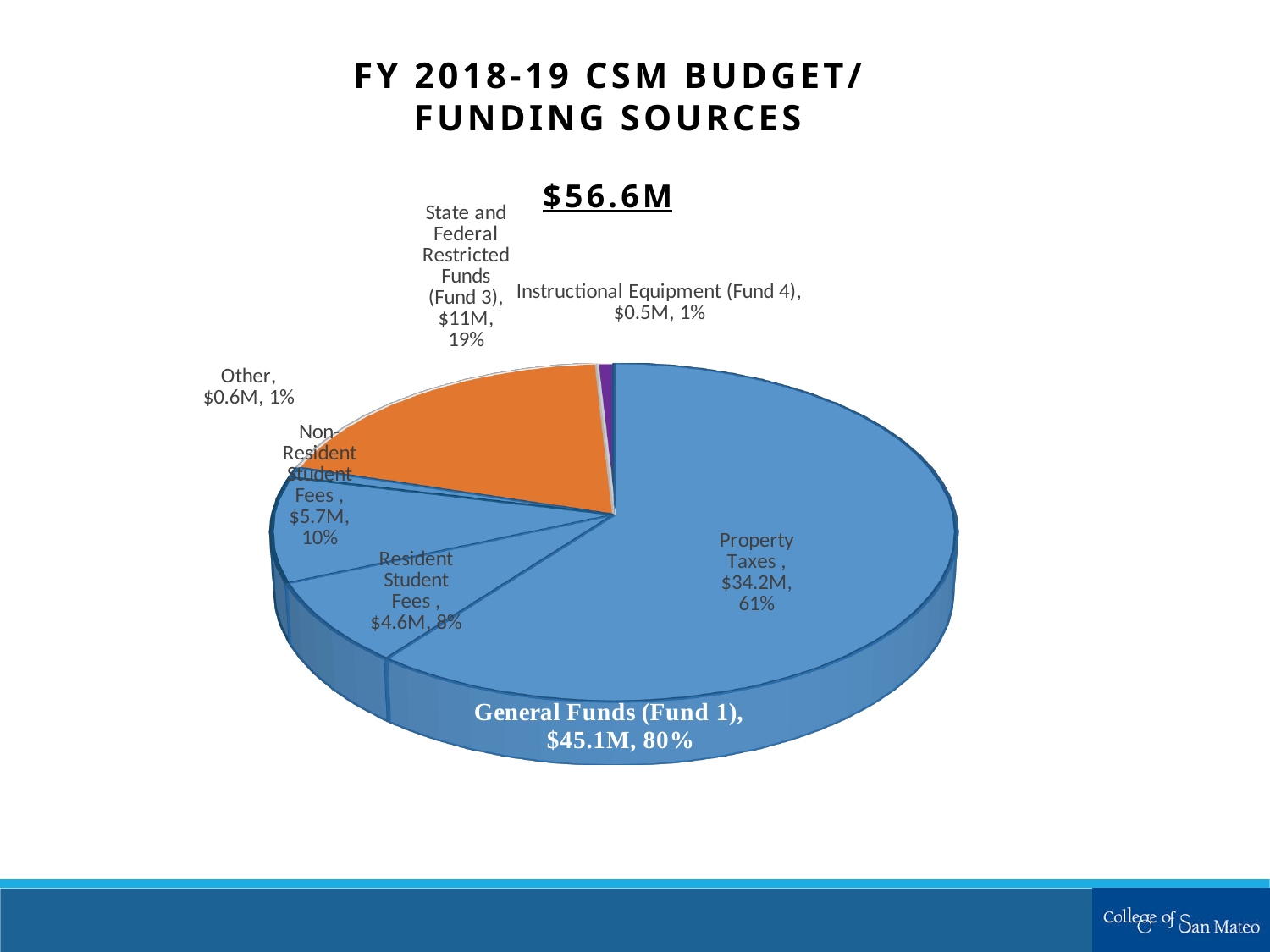
Which funding source has the smallest dollar value? Instructional Equipment (Fund 4) What is the value for State and Federal Restricted Funds (Fund 3)? $11M What share of the pie does State and Federal Restricted Funds (Fund 3) represent? 19% What share of the pie does Property Taxes represent? 61% What is the value for Non-Resident Student Fees? $5.7M What total budget amount is shown above the pie chart? $56.6M What is the value for Property Taxes? $34.2M What type of chart is shown on the slide? pie chart Which is larger, Non-Resident Student Fees or Resident Student Fees? Non-Resident Student Fees What is the value for Instructional Equipment (Fund 4)? $0.5M Which funding source is the largest slice of the pie? Property Taxes What is the difference in value between Property Taxes and State and Federal Restricted Funds (Fund 3)? $23.2M